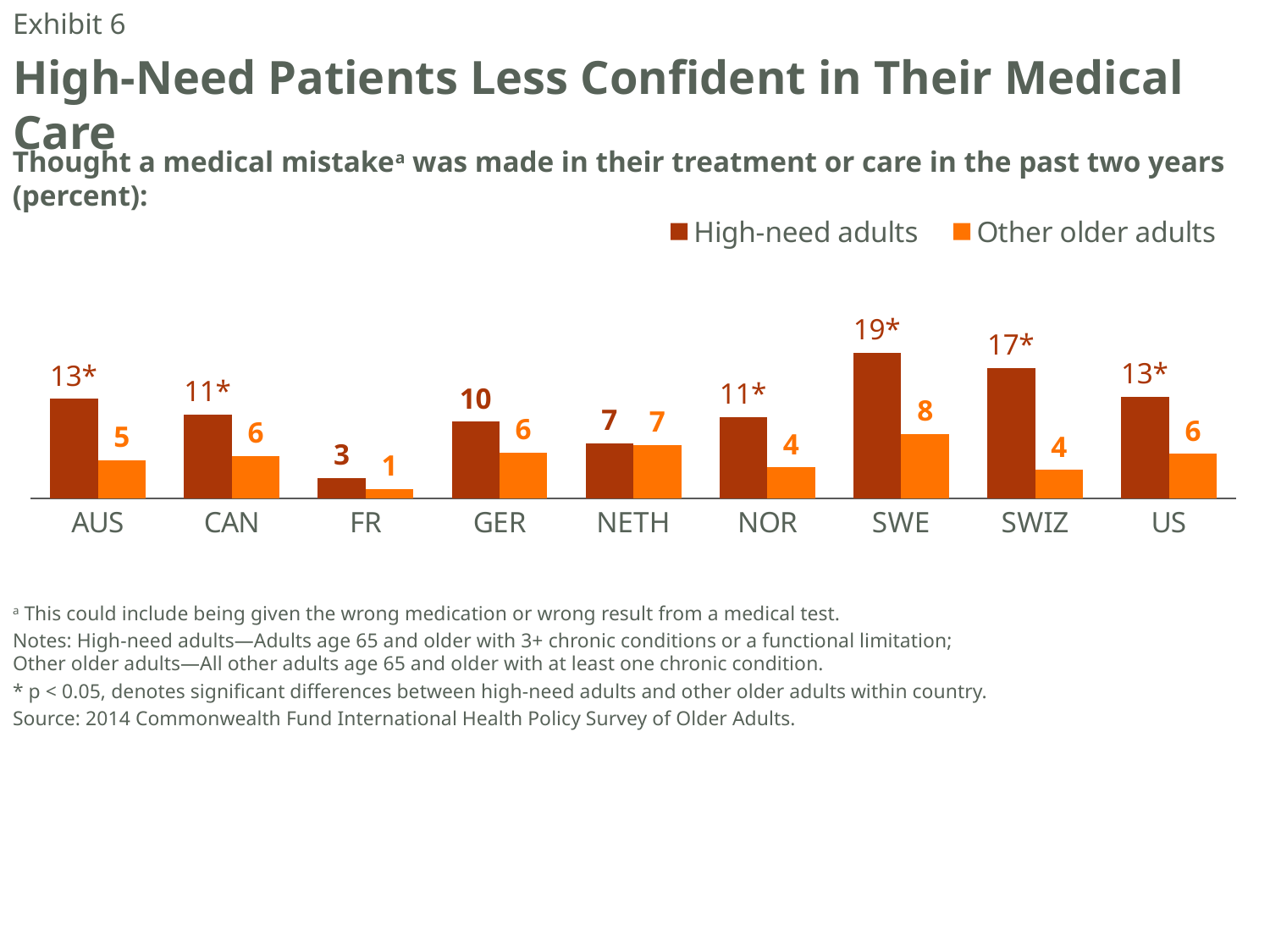
What colour are the bars for Other older adults? Orange What is the value for High-need adults in FR? 3 What kind of chart is shown on the slide? Bar chart How many series does the legend list? 2 What is the value for High-need adults in SWE? 19* Which country has the lowest value for Other older adults? FR Which country has the highest value for Other older adults? SWE What is the difference between High-need adults and Other older adults in SWIZ? 13 Which country has the highest value for High-need adults? SWE Which is larger in NOR: High-need adults or Other older adults? High-need adults How many countries are shown on the x axis? 9 What is the value for Other older adults in GER? 6